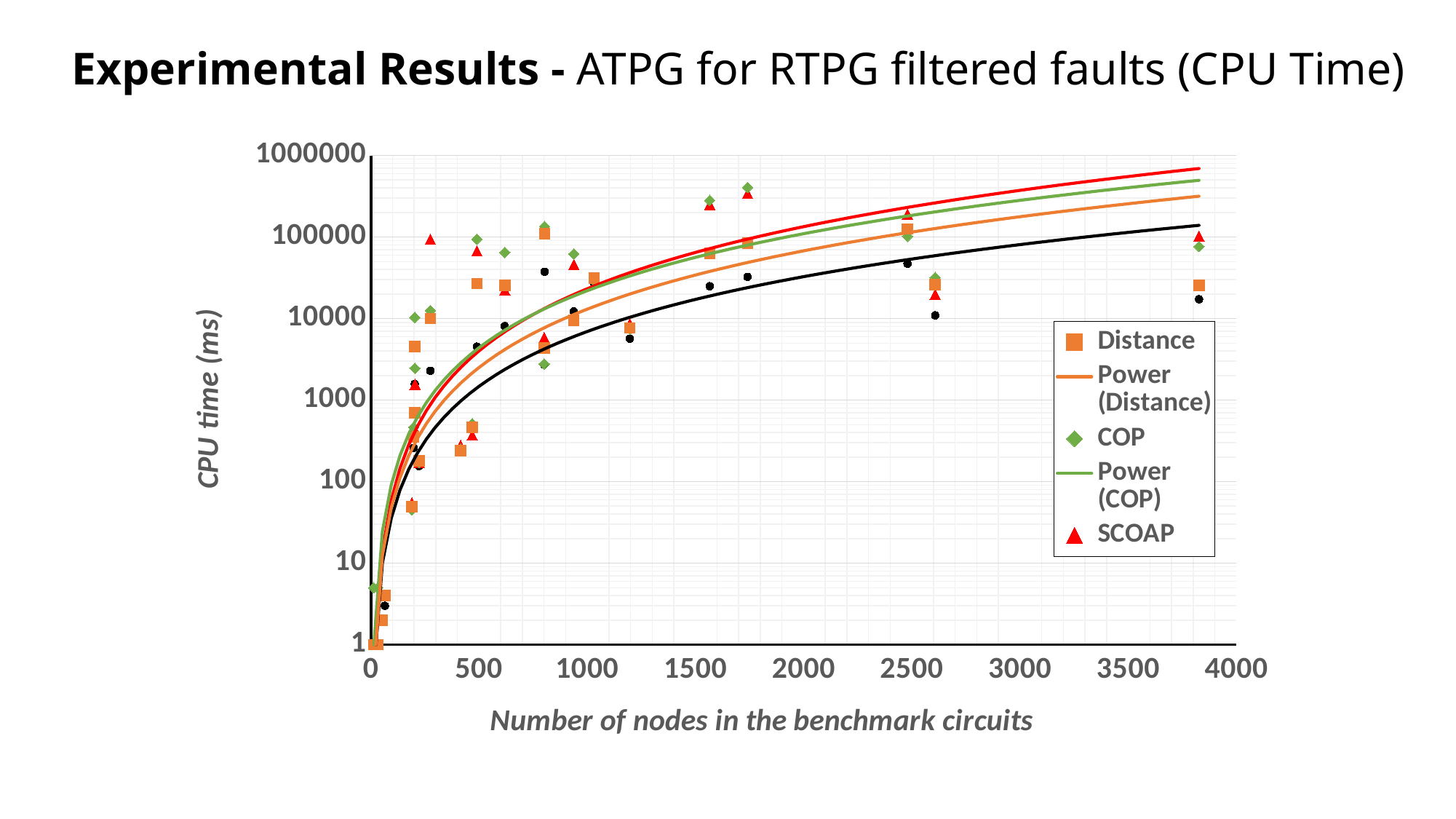
How many series does the legend list? 5 What is the title of the y axis? CPU time (ms) At about 1550 nodes, which is larger: the COP value or the Distance value? COP At about 3800 nodes, which is larger: the COP value or the Distance value? COP What is the title of the x axis? Number of nodes in the benchmark circuits What is the highest tick value shown on the y axis? 1000000 Is the COP value at about 1750 nodes greater or less than 100000? greater Is the SCOAP value at about 1750 nodes greater or less than 100000? greater Is the Distance value at about 3800 nodes greater or less than 100000? less What kind of chart is shown on the slide? Scatter chart Do the fitted power curves rise or fall as the number of nodes increases? Rise